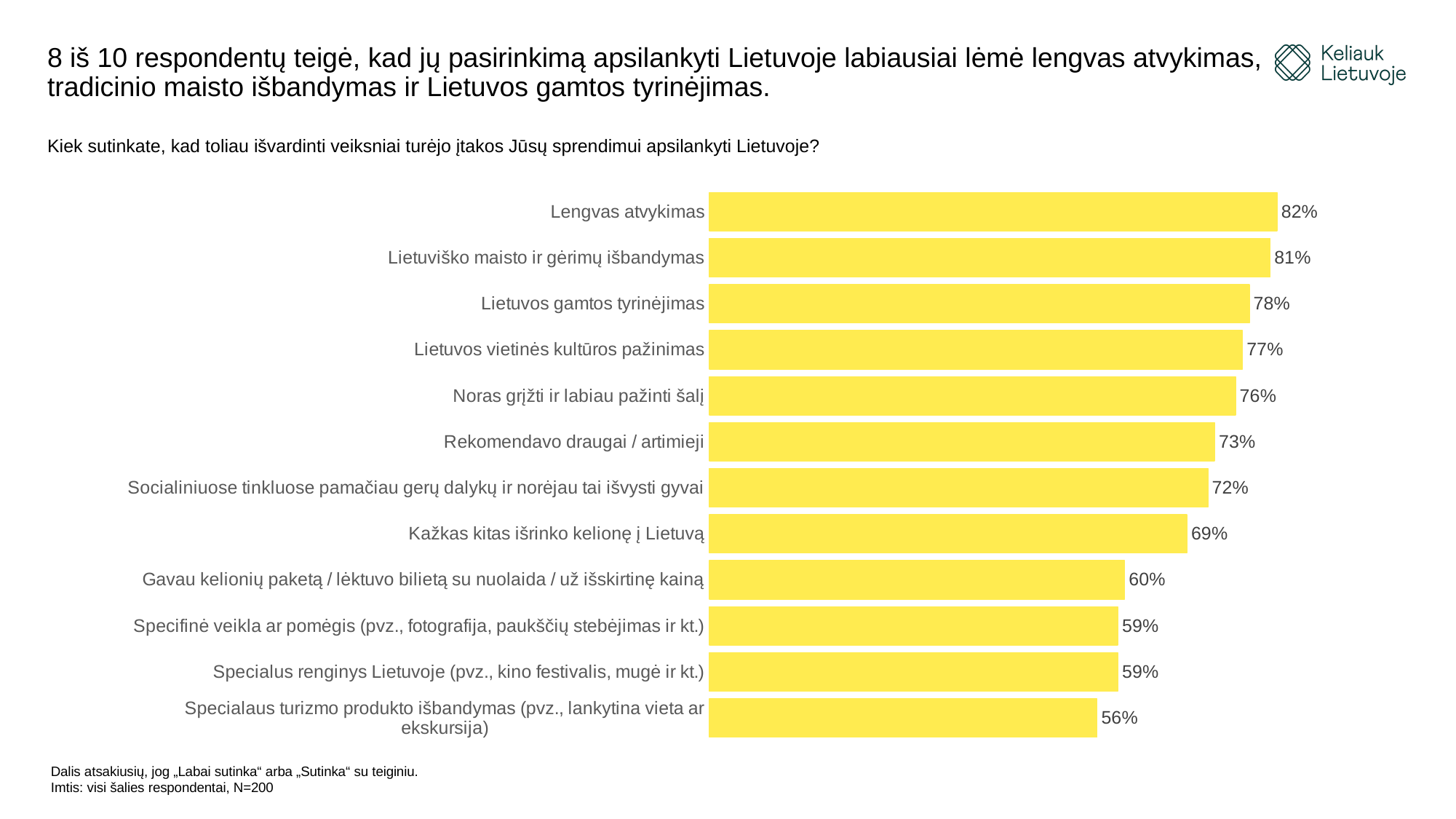
Which category has the lowest value? Specialaus turizmo produkto išbandymas (pvz., lankytina vieta ar ekskursija) What colour are the bars in the chart? Yellow What is the value for "Specifinė veikla ar pomėgis (pvz., fotografija, paukščių stebėjimas ir kt.)"? 59% What is the value for "Lengvas atvykimas"? 82% What kind of chart is shown on the slide? Bar chart Which category has the highest value? Lengvas atvykimas What is the difference between "Lengvas atvykimas" and "Lietuvos gamtos tyrinėjimas"? 4% What is the value for "Rekomendavo draugai / artimieji"? 73% How many categories are shown in the chart? 12 What is the difference between "Socialiniuose tinkluose pamačiau gerų dalykų ir norėjau tai išvysti gyvai" and "Gavau kelionių paketą / lėktuvo bilietą su nuolaida / už išskirtinę kainą"? 12% What is the value for "Kažkas kitas išrinko kelionę į Lietuvą"? 69% Which is larger: "Noras grįžti ir labiau pažinti šalį" or "Kažkas kitas išrinko kelionę į Lietuvą"? Noras grįžti ir labiau pažinti šalį